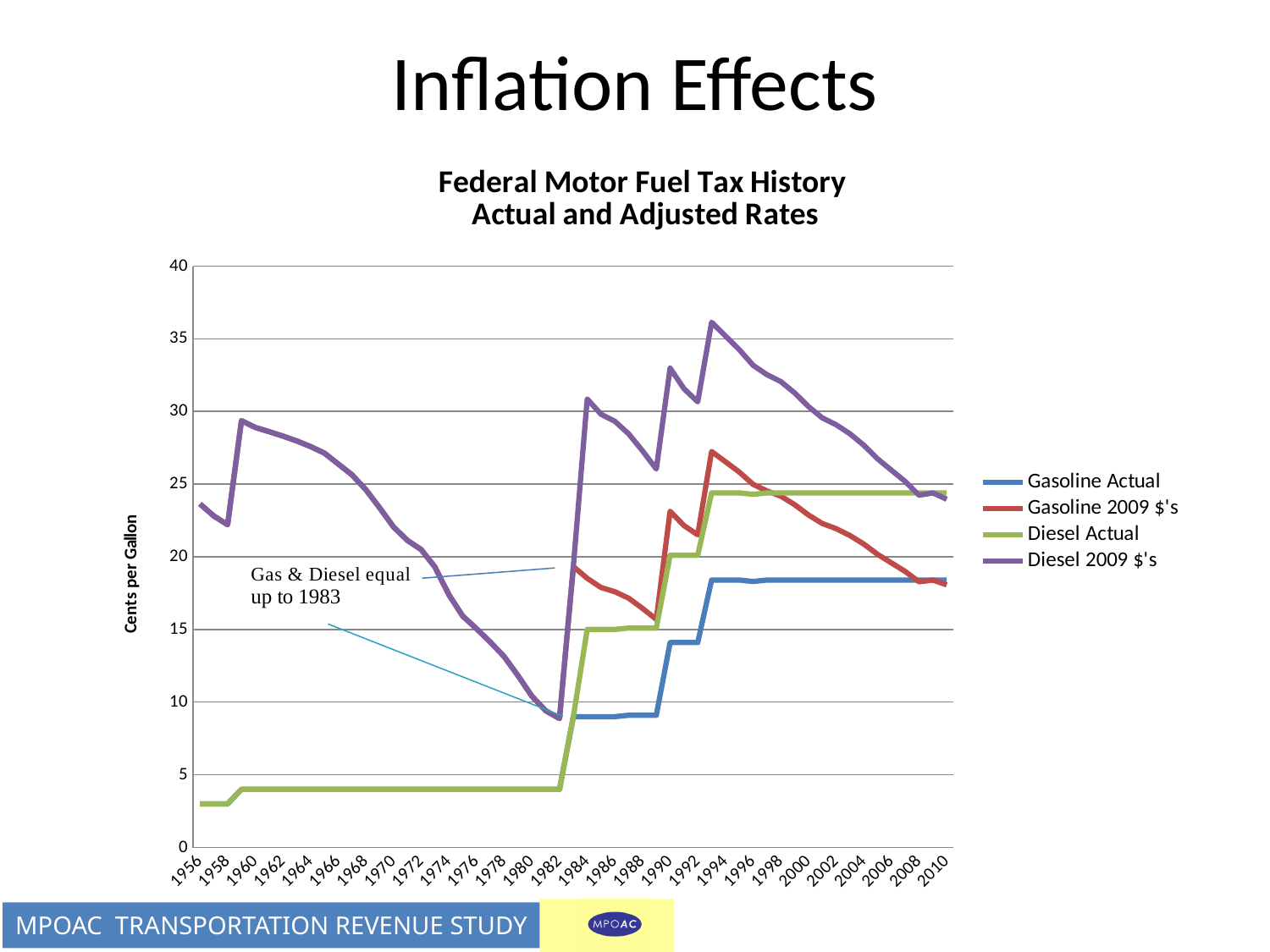
Does the Diesel 2009 $'s series rise or fall from 1994 to 2010? fall What is the title of the chart? Federal Motor Fuel Tax History Actual and Adjusted Rates What is the label on the vertical axis? Cents per Gallon Is the value for Diesel 2009 $'s in 1982 greater or less than 10? less Which series has the highest value in 1994? Diesel 2009 $'s Is the value for Gasoline Actual in 1970 greater or less than 5? less In 2010, which is larger: Diesel Actual or Gasoline Actual? Diesel Actual How many series does the legend list? 4 What kind of chart is shown on the slide? Line chart Is the value for Gasoline Actual in 2010 greater or less than 20? less